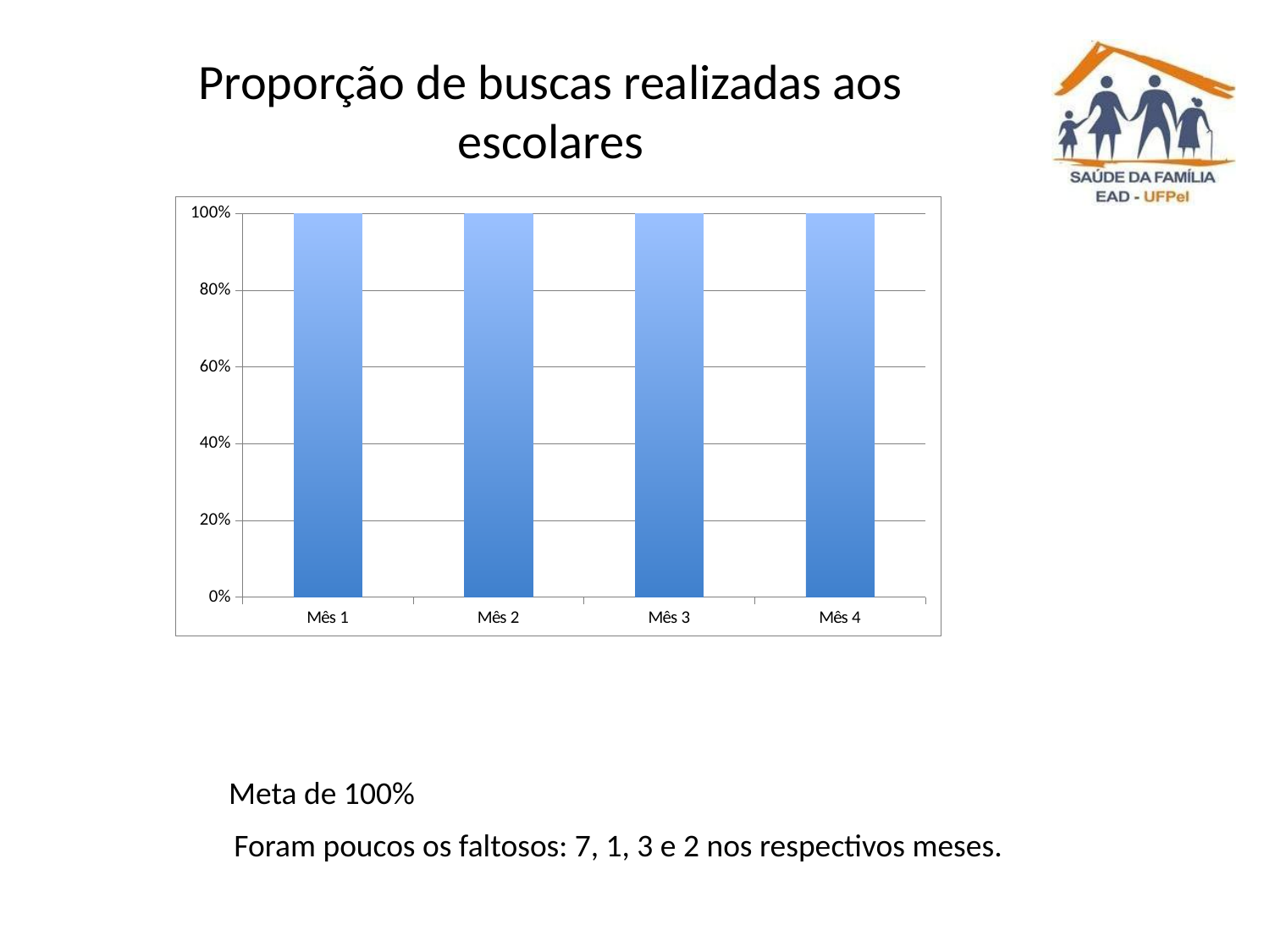
What is the value for Mês 3? 100% What is the highest value shown on the y axis? 100% How many categories (months) are shown on the x axis? 4 Do the values rise, fall, or stay the same from Mês 1 to Mês 4? Stay the same Is the value for Mês 2 greater or less than 80%? greater What is the value for Mês 1? 100% What is the title of the chart on the slide? Proporção de buscas realizadas aos escolares What is the difference between the values for Mês 1 and Mês 4? 0% What kind of chart is shown on the slide? Bar chart What is the value for Mês 4? 100%